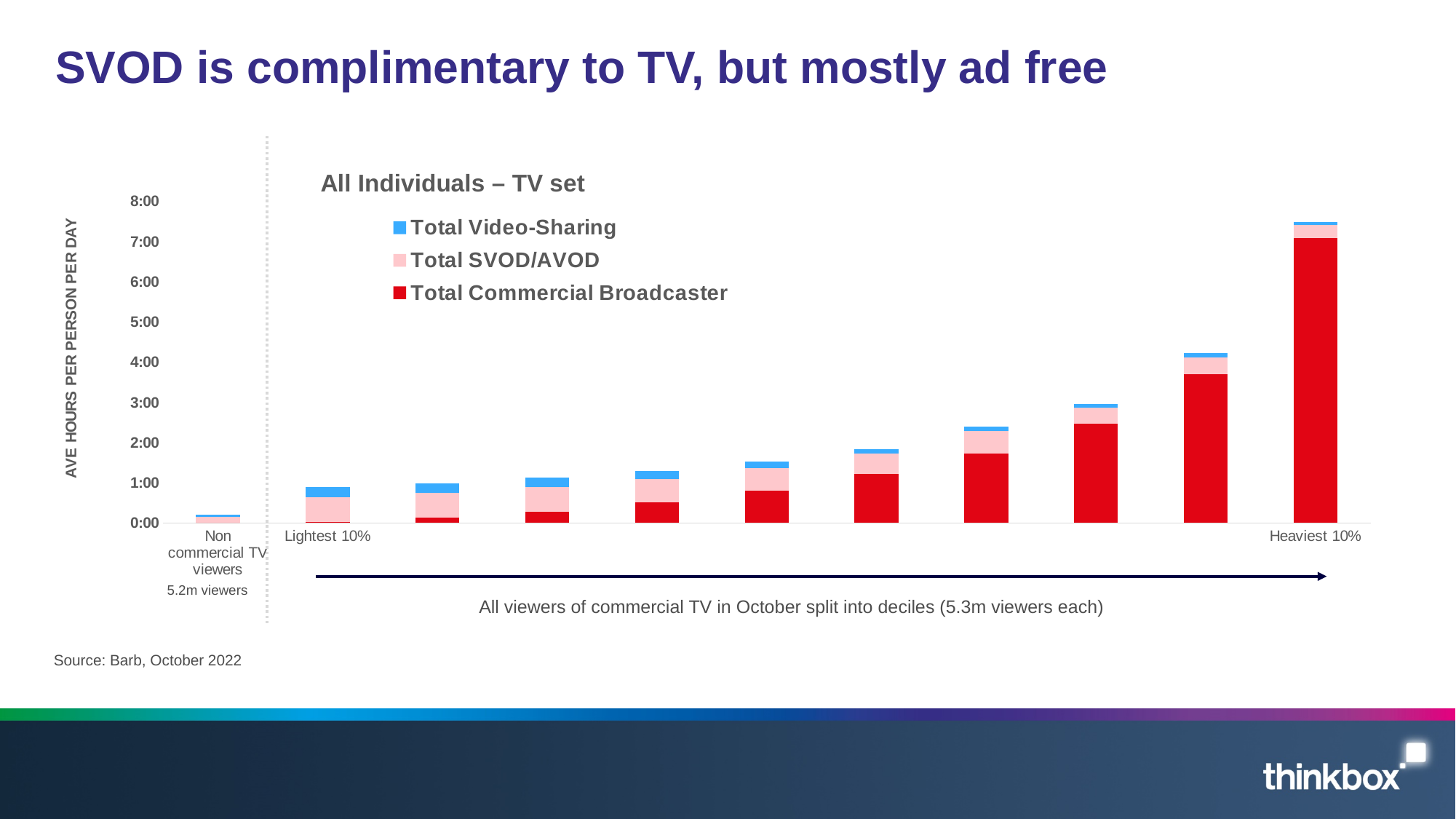
Do the stacked bar totals rise or fall moving from Lightest 10% to Heaviest 10%? rise Which category has the shortest stacked bar? Non commercial TV viewers Which series is shown in red in the chart? Total Commercial Broadcaster Which has a larger total stacked bar, Lightest 10% or Heaviest 10%? Heaviest 10% Is the total stacked value for Heaviest 10% greater or less than 7:00? greater What kind of chart is shown on the slide? Stacked bar chart Which category has the tallest stacked bar? Heaviest 10% How many series does the chart legend list? 3 What is the title of the chart? All Individuals – TV set How many bars are plotted in the chart? 11 Is the total stacked value for Lightest 10% greater or less than 2:00? less Is the Total Commercial Broadcaster value for Heaviest 10% greater or less than 6:00? greater